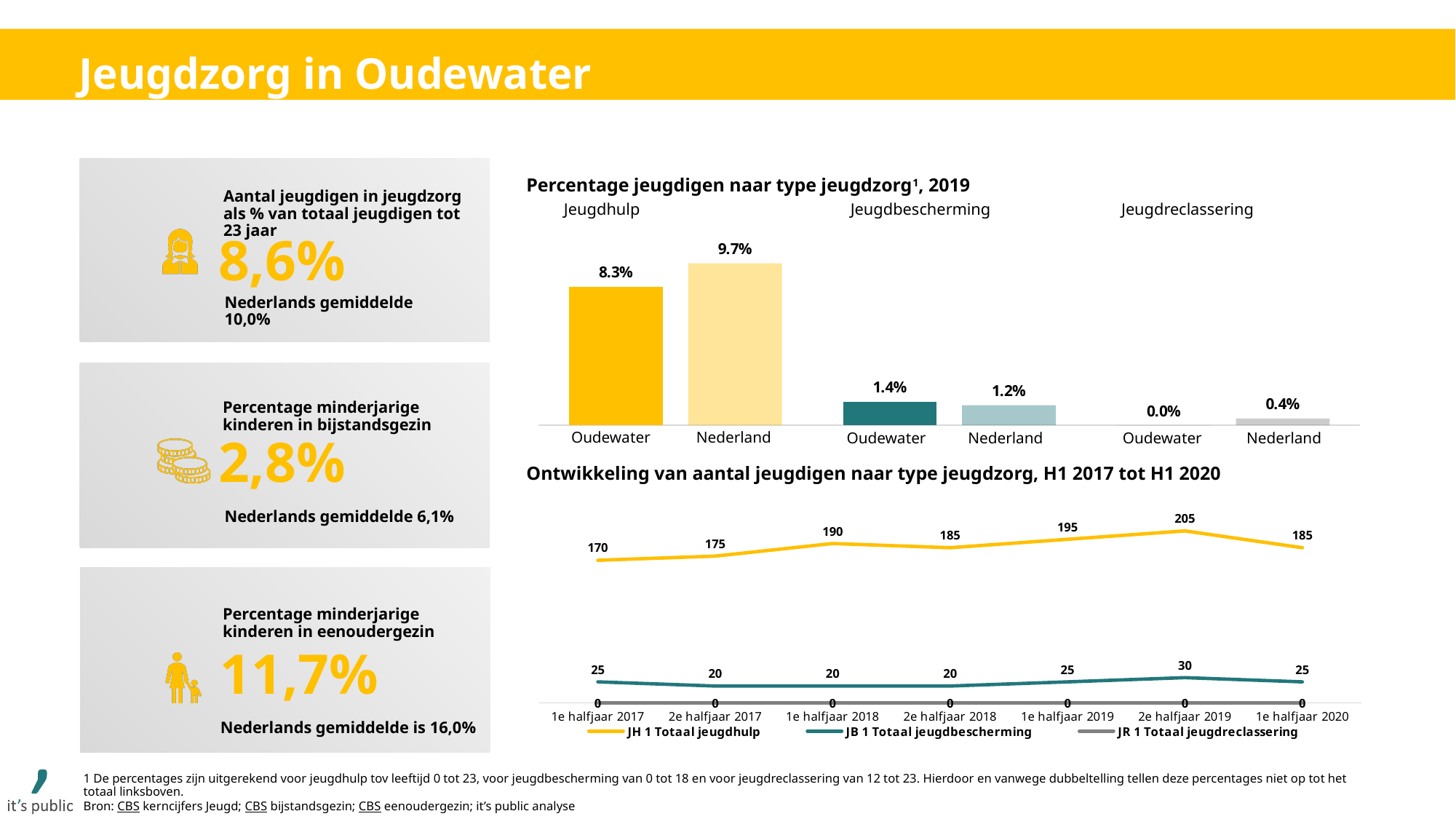
In the bar chart 'Percentage jeugdigen naar type jeugdzorg, 2019', what is the difference between the Jeugdhulp values for Nederland and Oudewater? 1.4% In the bar chart 'Percentage jeugdigen naar type jeugdzorg, 2019', which is larger for Jeugdbescherming: Oudewater or Nederland? Oudewater In the bar chart 'Percentage jeugdigen naar type jeugdzorg, 2019', which bar is the highest? Nederland (Jeugdhulp), 9.7% In the bar chart 'Percentage jeugdigen naar type jeugdzorg, 2019', what is the Jeugdreclassering value for Oudewater? 0.0% In the line chart 'Ontwikkeling van aantal jeugdigen naar type jeugdzorg', how many time periods are shown on the x axis? 7 In the line chart 'Ontwikkeling van aantal jeugdigen naar type jeugdzorg', what is the difference between JH 1 Totaal jeugdhulp in 2e halfjaar 2019 and 1e halfjaar 2020? 20 In the line chart 'Ontwikkeling van aantal jeugdigen naar type jeugdzorg', what is the value of JH 1 Totaal jeugdhulp in 2e halfjaar 2019? 205 In the line chart 'Ontwikkeling van aantal jeugdigen naar type jeugdzorg', how many series does the legend list? 3 In the bar chart 'Percentage jeugdigen naar type jeugdzorg, 2019', what is the Jeugdbescherming value for Nederland? 1.2% In the line chart 'Ontwikkeling van aantal jeugdigen naar type jeugdzorg', in which period is JB 1 Totaal jeugdbescherming highest? 2e halfjaar 2019 In the bar chart 'Percentage jeugdigen naar type jeugdzorg, 2019', what is the Jeugdhulp value for Oudewater? 8.3% What kind of chart is 'Ontwikkeling van aantal jeugdigen naar type jeugdzorg, H1 2017 tot H1 2020'? Line chart